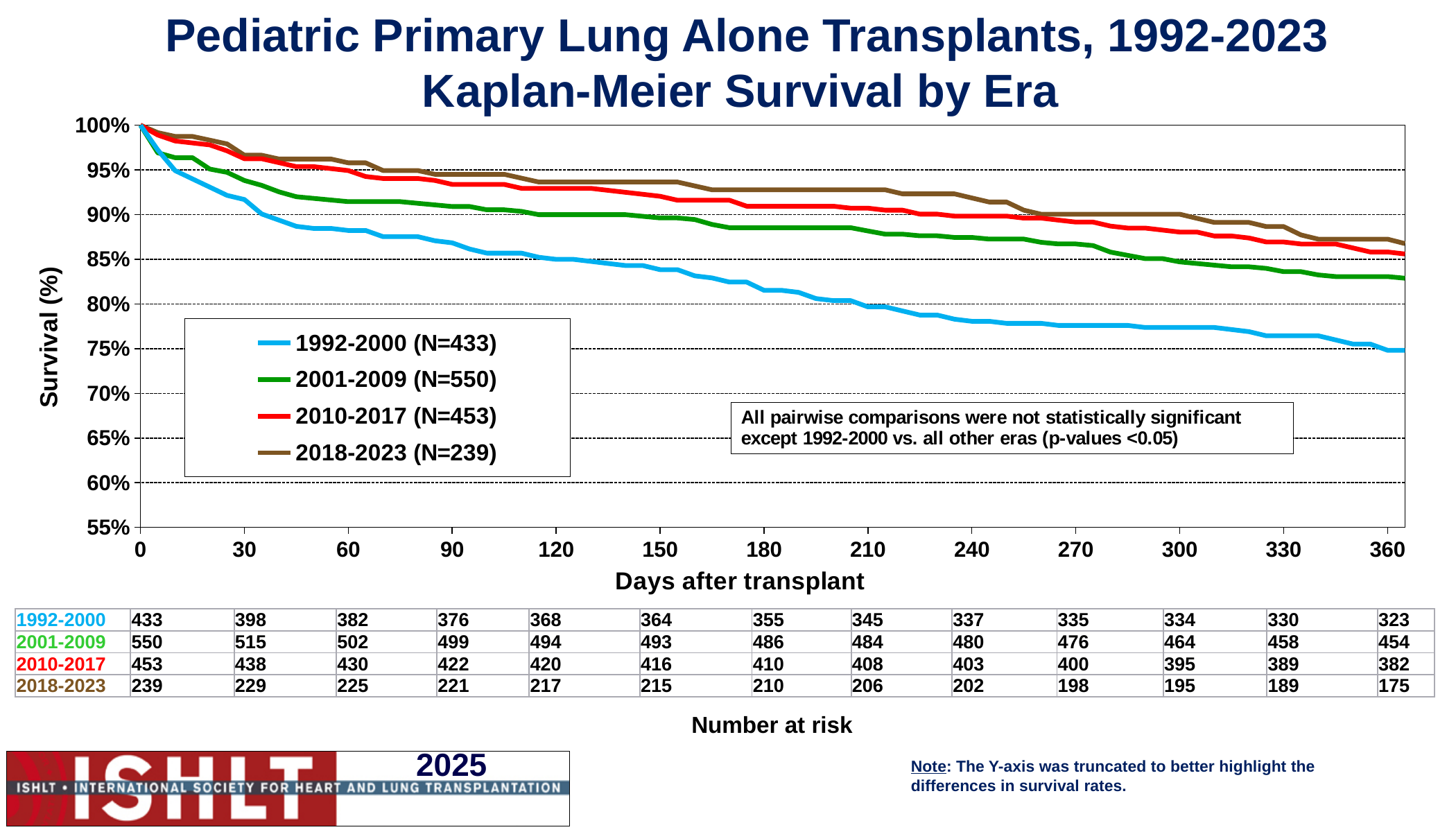
In the number at risk table, how many patients were at risk for the 1992-2000 era at day 0? 433 In the number at risk table, how many patients were at risk for the 2018-2023 era at day 360? 175 Do the survival curves rise or fall as days after transplant increase? fall At day 360, is the survival for the 1992-2000 era greater or less than 80%? less What is the N for the 2001-2009 era shown in the legend? 550 In the number at risk table, what is the difference between the number at risk for the 2010-2017 era at day 0 and at day 360? 71 At day 360, which era has higher survival: 1992-2000 or 2018-2023? 2018-2023 How many eras (series) does the legend list? 4 Which era has the lowest survival curve at day 360? 1992-2000 In the number at risk table, how many patients were at risk for the 2001-2009 era at day 180? 486 At day 360, is the survival for the 2018-2023 era greater or less than 85%? greater What kind of chart is shown on the slide? line chart